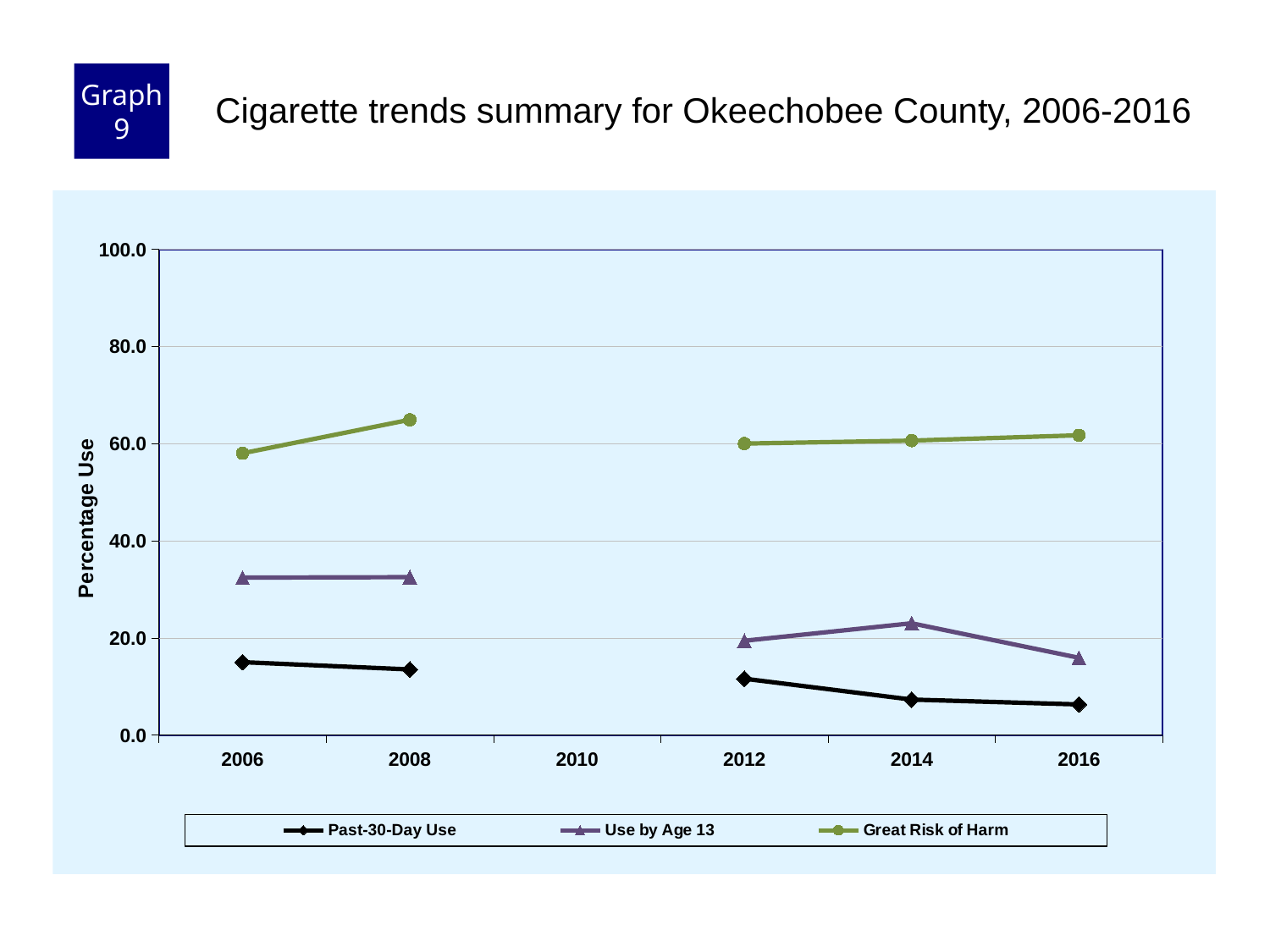
Is the value for Use by Age 13 in 2016 greater or less than 20.0? less What is the title of the chart? Cigarette trends summary for Okeechobee County, 2006-2016 How many series does the legend list? 3 Which series has the lowest values across all years shown? Past-30-Day Use What is the label on the vertical axis? Percentage Use Is the value for Use by Age 13 in 2006 greater or less than 20.0? greater Does Past-30-Day Use rise or fall from 2012 to 2016? fall Is the value for Great Risk of Harm in 2008 greater or less than 60.0? greater What kind of chart is shown on the slide? line chart Which series has the highest values across all years shown? Great Risk of Harm Which is larger, Use by Age 13 in 2014 or Use by Age 13 in 2016? 2014